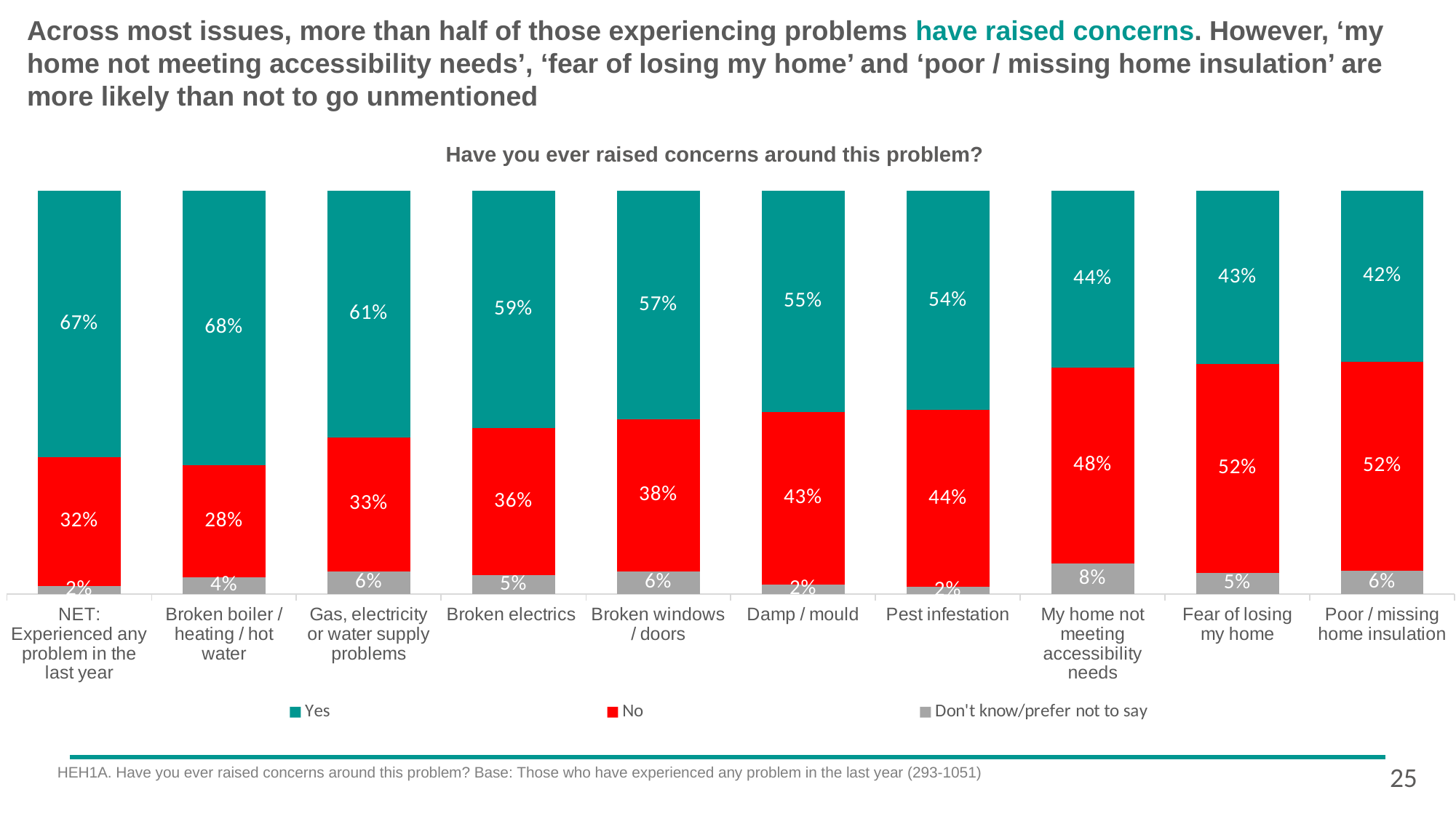
What is the difference between the 'Yes' and 'No' percentages for 'Pest infestation'? 10 percentage points What is the 'No' value for 'My home not meeting accessibility needs'? 48% What kind of chart is shown on the slide? Stacked bar chart Which category has the highest 'Yes' percentage? Broken boiler / heating / hot water Which category has the lowest 'Yes' percentage? Poor / missing home insulation Which is larger for 'Fear of losing my home': the 'Yes' share or the 'No' share? No What is the title of the chart? Have you ever raised concerns around this problem? Which category has the highest 'Don't know/prefer not to say' percentage? My home not meeting accessibility needs How many series does the legend list? 3 What is the 'Don't know/prefer not to say' value for 'Broken boiler / heating / hot water'? 4% What percentage of those experiencing 'Damp / mould' answered 'Yes' to having raised concerns? 55% How many problem categories are shown on the x axis? 10